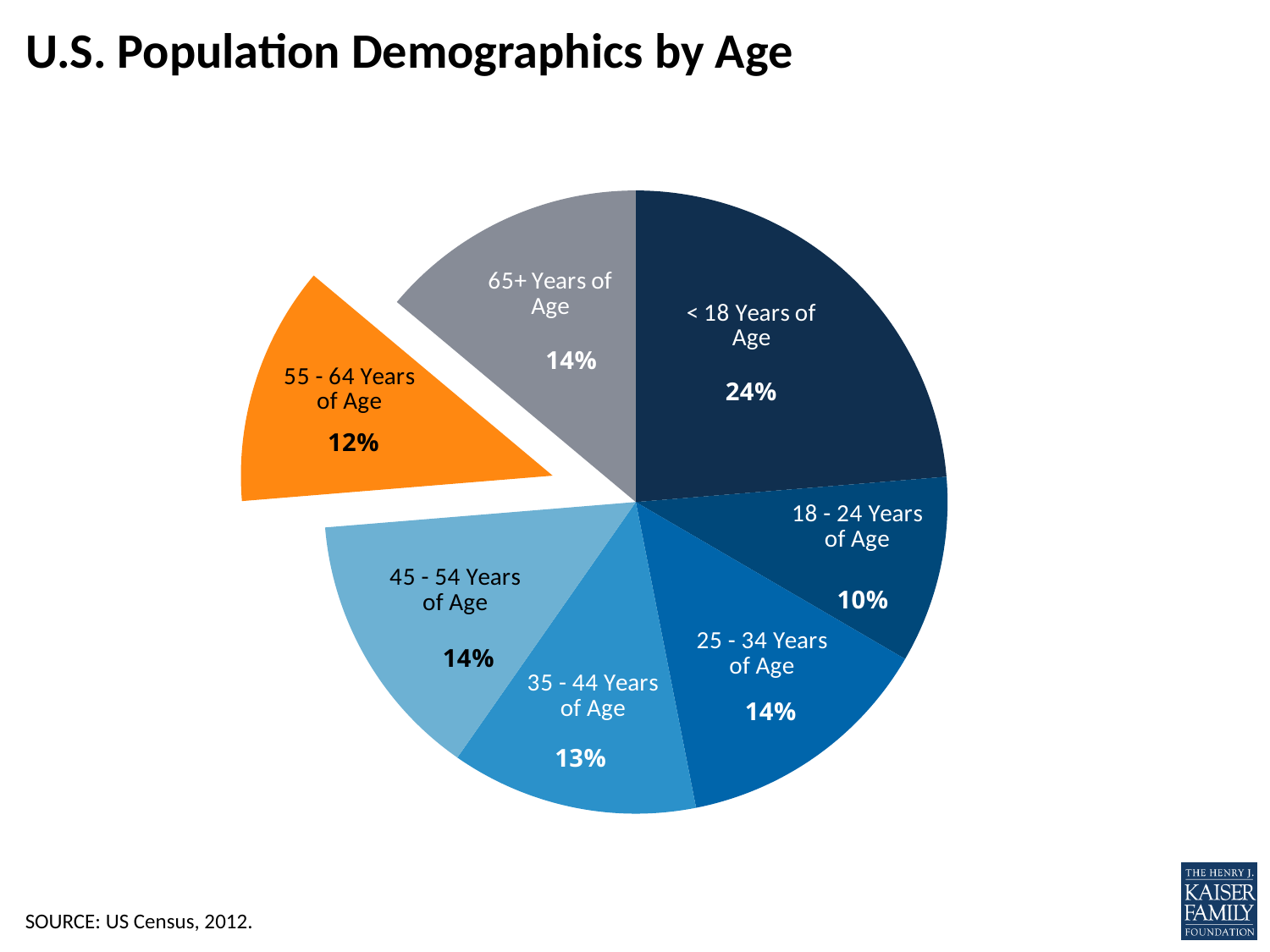
What share of the U.S. population is under 18 years of age? 24% What type of chart is shown on the slide? Pie chart What is the difference in percentage points between the < 18 Years of Age slice and the 18 - 24 Years of Age slice? 14 What is the title of the chart? U.S. Population Demographics by Age What percentage is shown for the 18 - 24 Years of Age slice? 10% Which age group has the smallest share of the population? 18 - 24 Years of Age How many age groups are shown in the pie chart? 7 Which slice is pulled out from the rest of the pie? 55 - 64 Years of Age Which age group has the largest share of the population? < 18 Years of Age What percentage is shown for the 55 - 64 Years of Age slice? 12% Which is larger, the share for 35 - 44 Years of Age or the share for 55 - 64 Years of Age? 35 - 44 Years of Age What percentage is shown for the 35 - 44 Years of Age slice? 13%